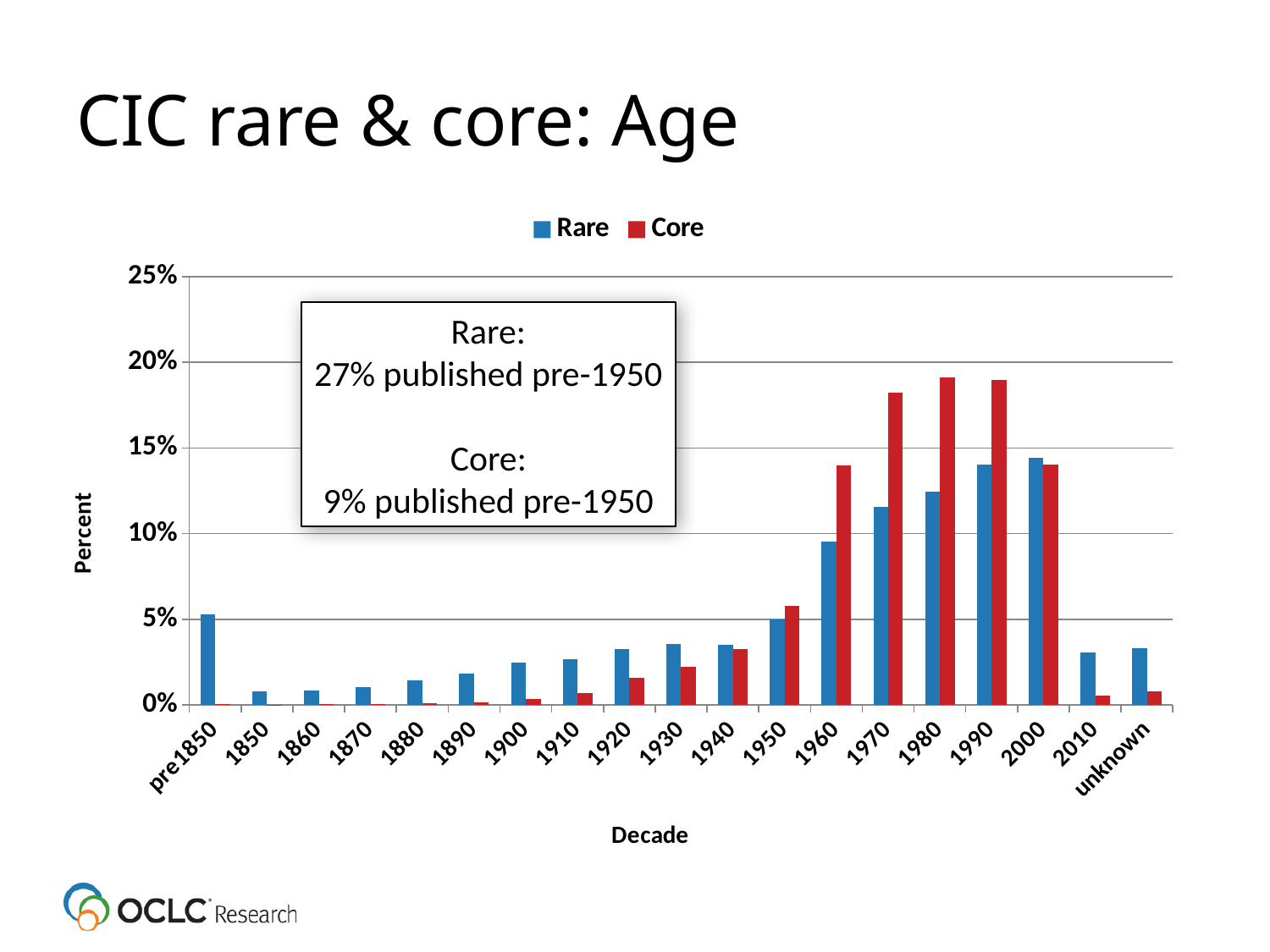
What kind of chart is shown on the slide? bar chart According to the text box on the chart, what percentage of Rare items were published pre-1950? 27% How many series does the legend list? 2 For pre1850, which series has the larger value, Rare or Core? Rare Is the Rare value for 1970 greater or less than 10%? greater Is the Core value for 1930 greater or less than 5%? less Is the Rare value for 2000 greater or less than 10%? greater How many decade categories are shown on the x axis? 19 Do the Core values rise or fall from 1990 to 2010? fall For 1970, which series has the larger value, Rare or Core? Core